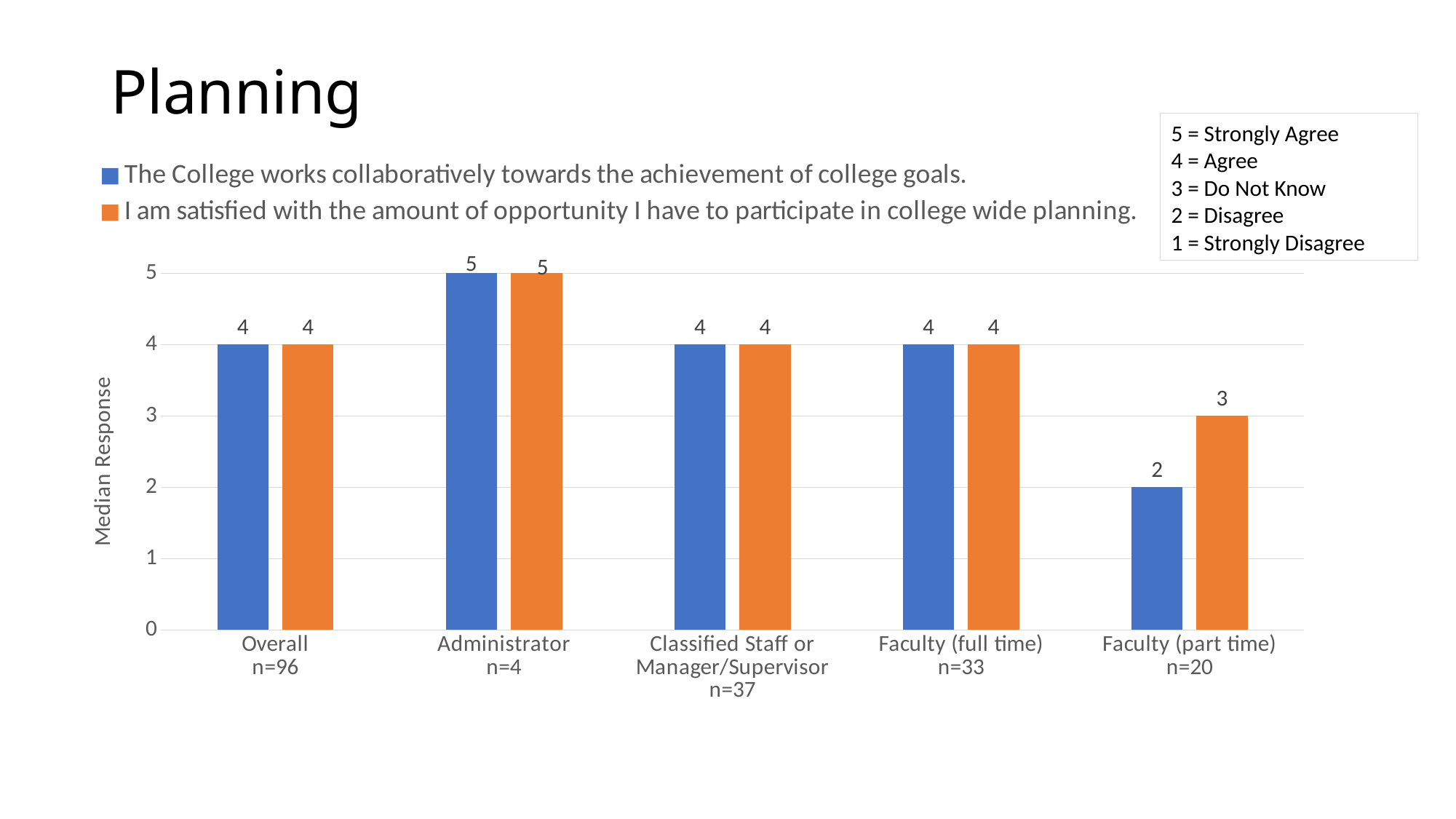
Which group has the lowest median response for "I am satisfied with the amount of opportunity I have to participate in college wide planning."? Faculty (part time) n=20 For Faculty (part time) (n=20), which statement has the larger median response? I am satisfied with the amount of opportunity I have to participate in college wide planning. What is the median response for Faculty (part time) (n=20) on "The College works collaboratively towards the achievement of college goals."? 2 What is the median response for Administrator (n=4) on "The College works collaboratively towards the achievement of college goals."? 5 How many groups are shown on the x axis? 5 What is the label of the vertical axis? Median Response What is the difference between the two median responses for Faculty (part time) (n=20)? 1 Which group has the highest median response for "The College works collaboratively towards the achievement of college goals."? Administrator n=4 What is the median response for Faculty (part time) (n=20) on "I am satisfied with the amount of opportunity I have to participate in college wide planning."? 3 How many series does the legend list? 2 What is the median response for Overall (n=96) on "I am satisfied with the amount of opportunity I have to participate in college wide planning."? 4 What kind of chart is shown on the slide? Bar chart